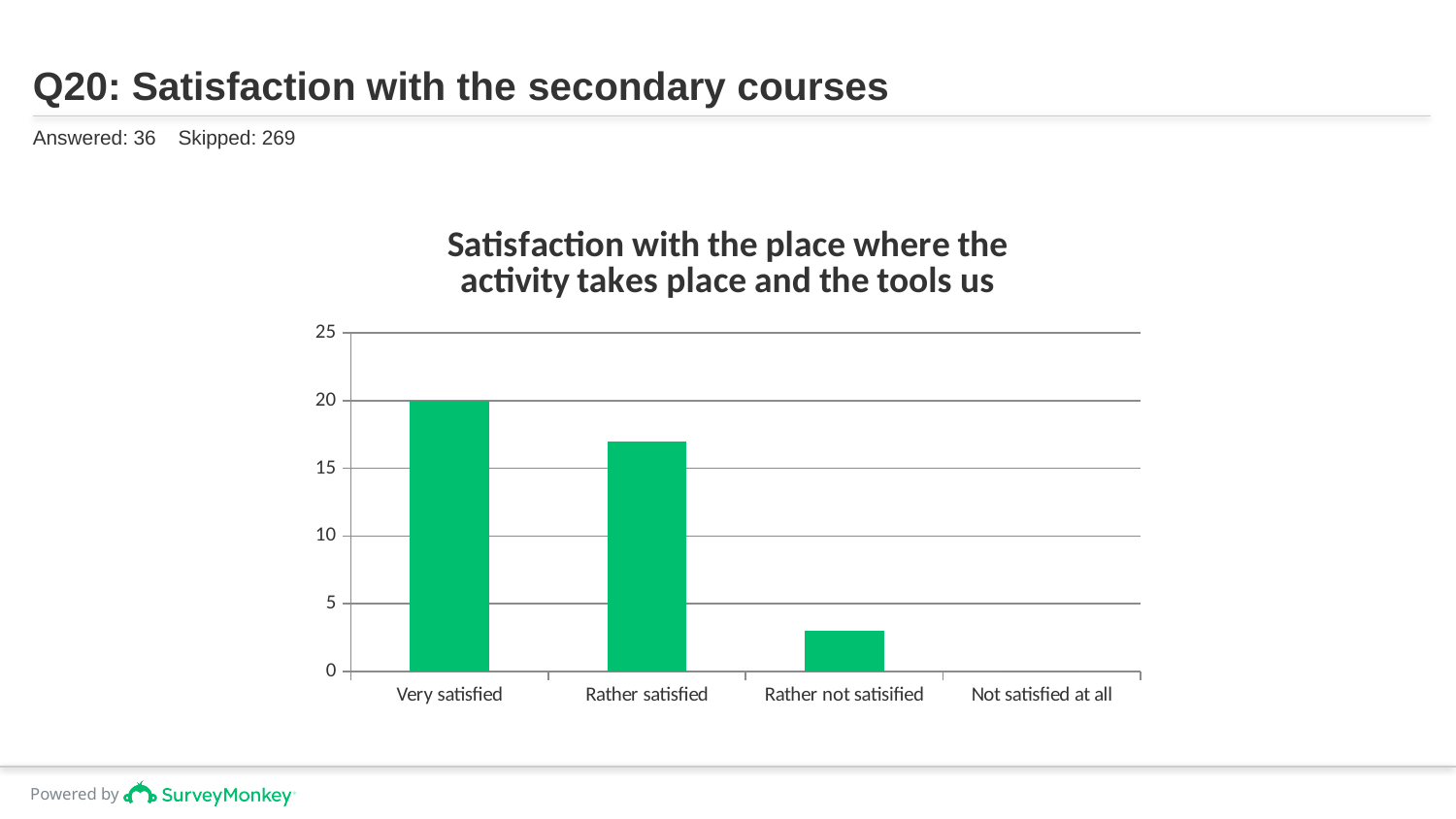
What is the difference between the values for Very satisfied and Not satisfied at all? 20 How many categories are shown on the x axis? 4 What kind of chart is shown on the slide? Bar chart What is the value for Not satisfied at all? 0 What is the value for Very satisfied? 20 Which is larger, the value for Very satisfied or the value for Rather satisfied? Very satisfied Do the values rise or fall from left to right along the x axis? Fall Is the value for Rather not satisified greater or less than 5? less Which category has the lowest value? Not satisfied at all Which category has the highest value? Very satisfied What colour are the bars in the chart? Green Is the value for Rather satisfied greater or less than 15? greater